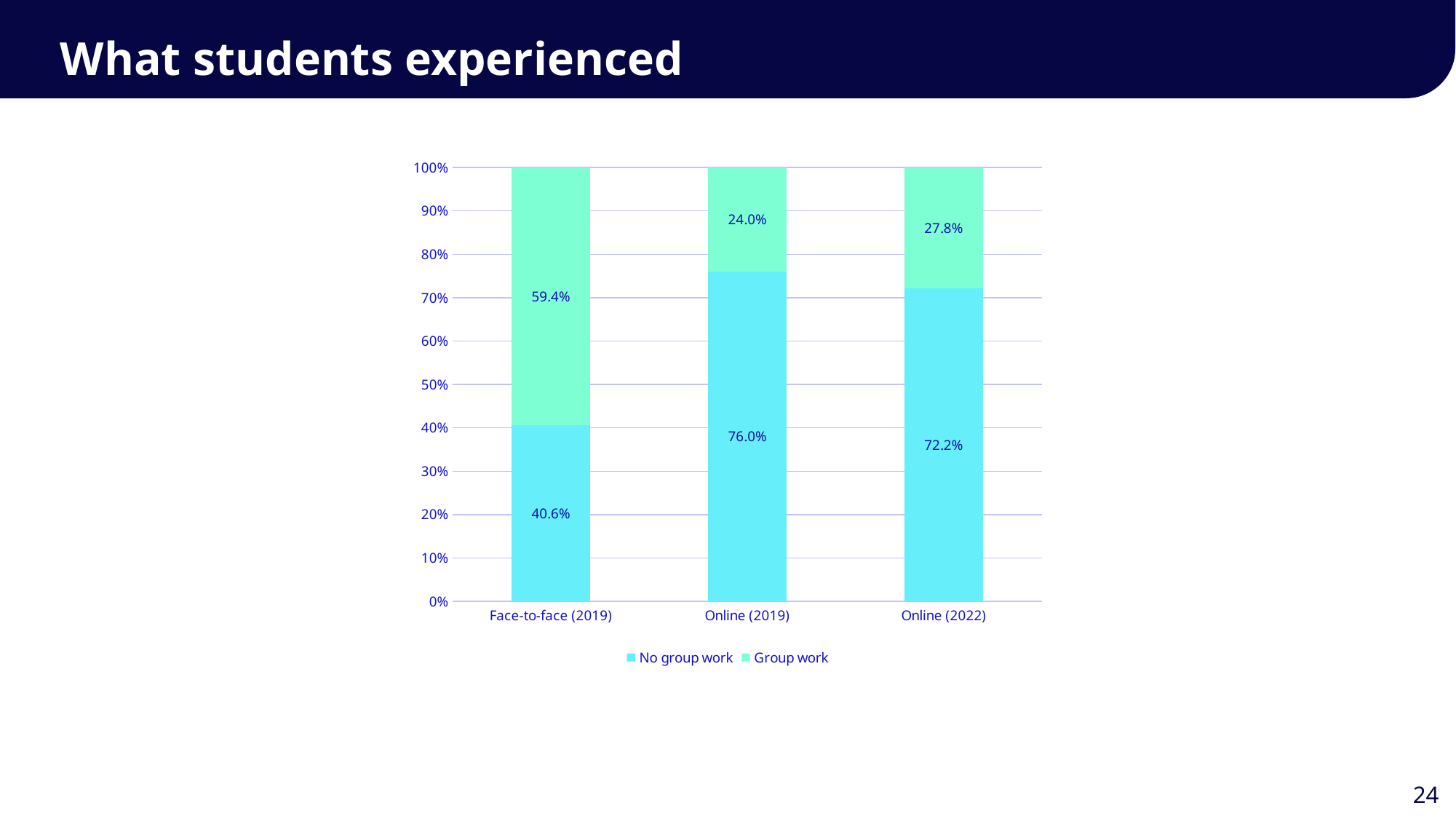
What is the value for Group work in the Face-to-face (2019) bar? 59.4% What is the difference between the No group work values for Online (2019) and Online (2022)? 3.8% Which category has the lowest value for Group work? Online (2019) What is the value for Group work in the Online (2019) bar? 24.0% Which category has the highest value for No group work? Online (2019) Which is larger: the Group work value for Face-to-face (2019) or for Online (2022)? Face-to-face (2019) How many categories are shown on the x axis? 3 What is the value for No group work in the Face-to-face (2019) bar? 40.6% What is the value for No group work in the Online (2022) bar? 72.2% How many series does the legend list? 2 What is the total of the stacked bar for Online (2022)? 100.0% What kind of chart is shown on the slide? Stacked bar chart